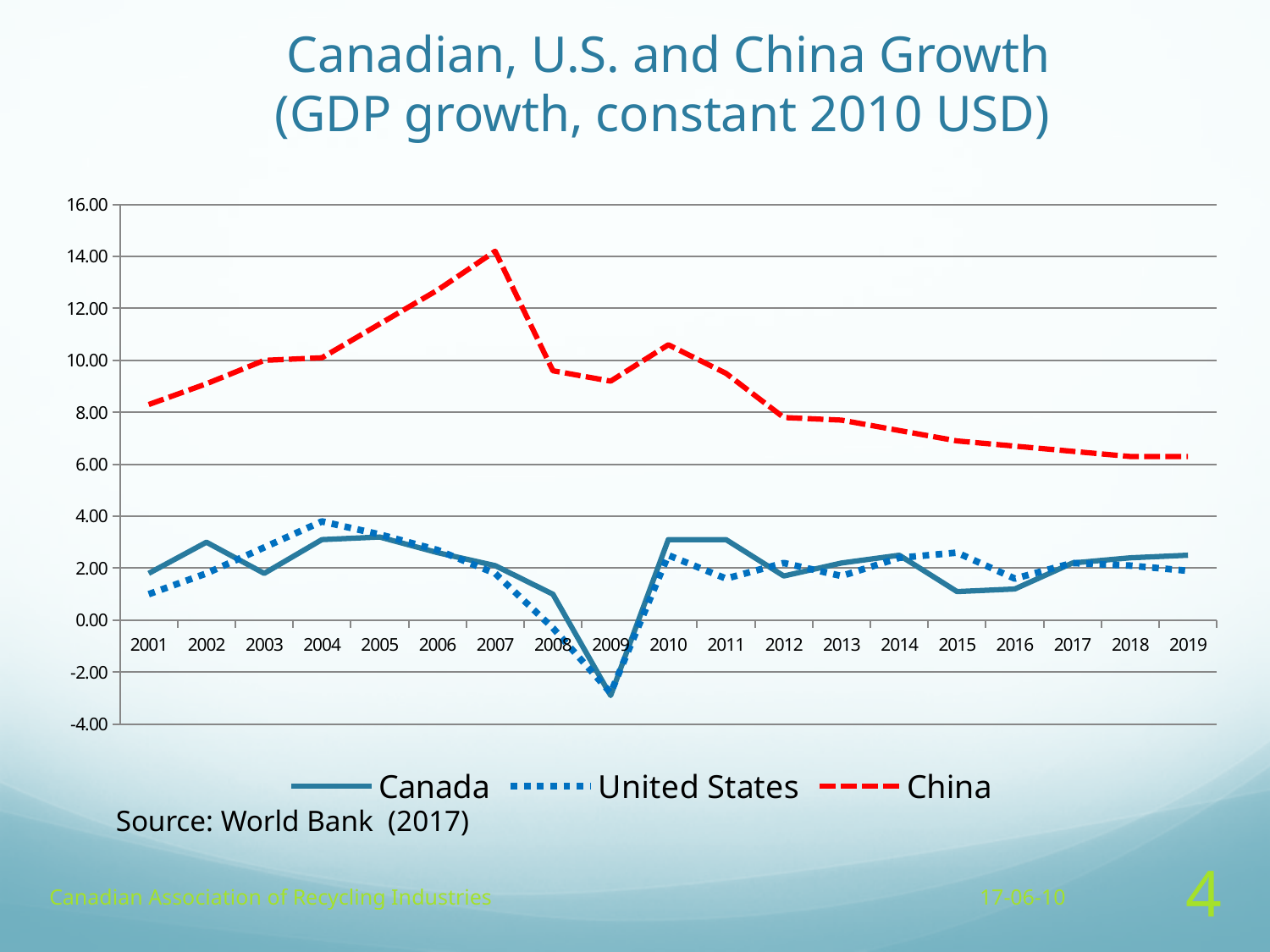
What kind of chart is shown on the slide? line chart In 2010, which series has the higher value, China or Canada? China How many years are shown along the x axis? 19 Is the value for China in 2019 greater or less than 8.00? less In which year does the China line reach its highest point? 2007 Does the China line rise or fall from 2010 to 2019? fall Is the value for China in 2007 greater or less than 12.00? greater Which series is drawn with a red dashed line? China Is the value for the United States in 2004 greater or less than 2.00? greater How many series does the legend list? 3 In which year does the Canada line reach its lowest point? 2009